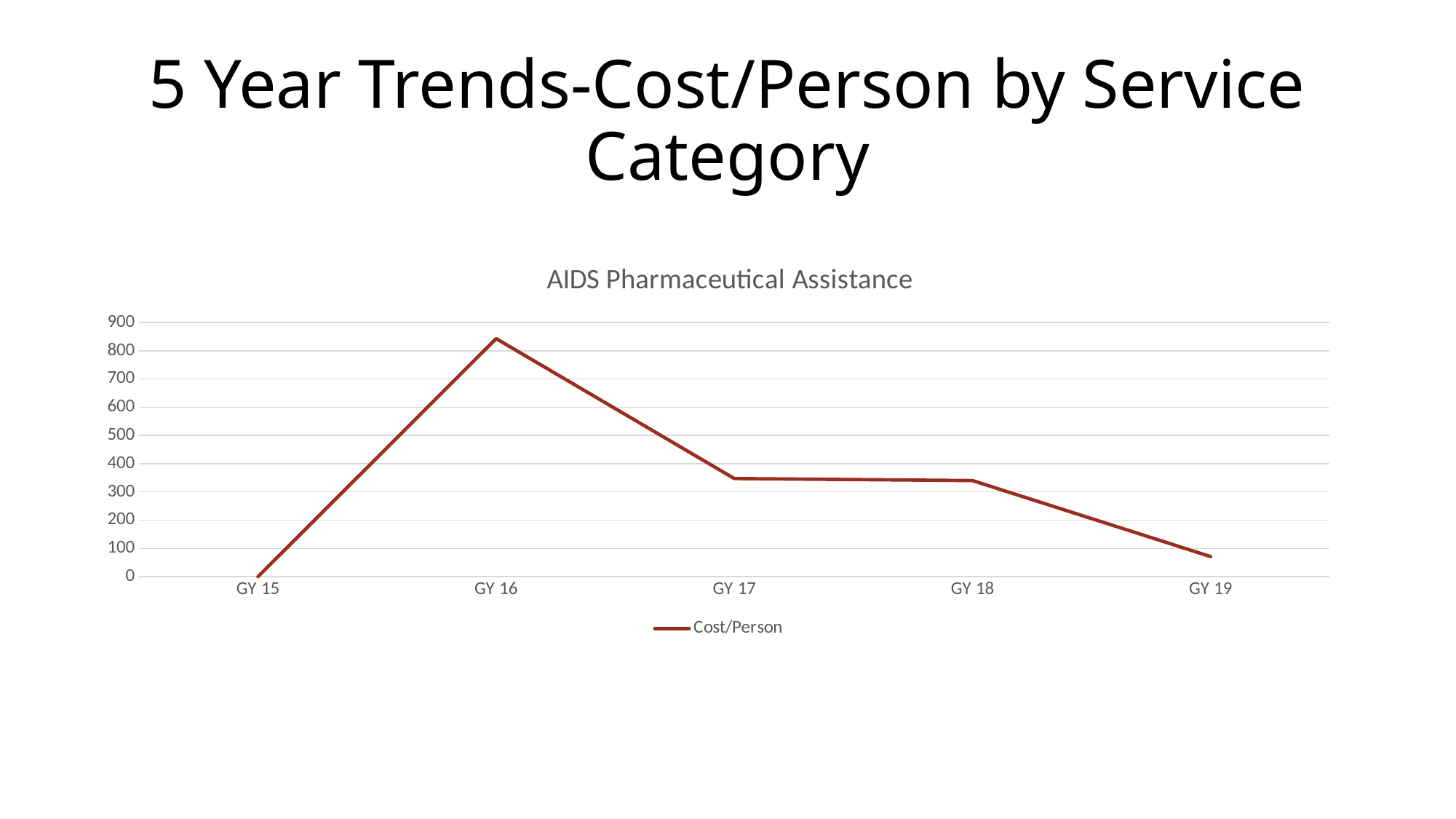
How many grant years are plotted on the x axis? 5 Is the Cost/Person value for GY 17 greater or less than 400? less How many series does the legend list? 1 Which grant year has the highest Cost/Person? GY 16 Does the Cost/Person rise or fall from GY 16 to GY 19? Fall What is the title of the chart? AIDS Pharmaceutical Assistance What is the name of the series shown in the legend? Cost/Person Which grant year has the lowest Cost/Person? GY 15 What is the Cost/Person value for GY 15? 0 Is the Cost/Person value for GY 19 greater or less than 100? less Is the Cost/Person value for GY 16 greater or less than 800? greater What type of chart is shown on the slide? Line chart